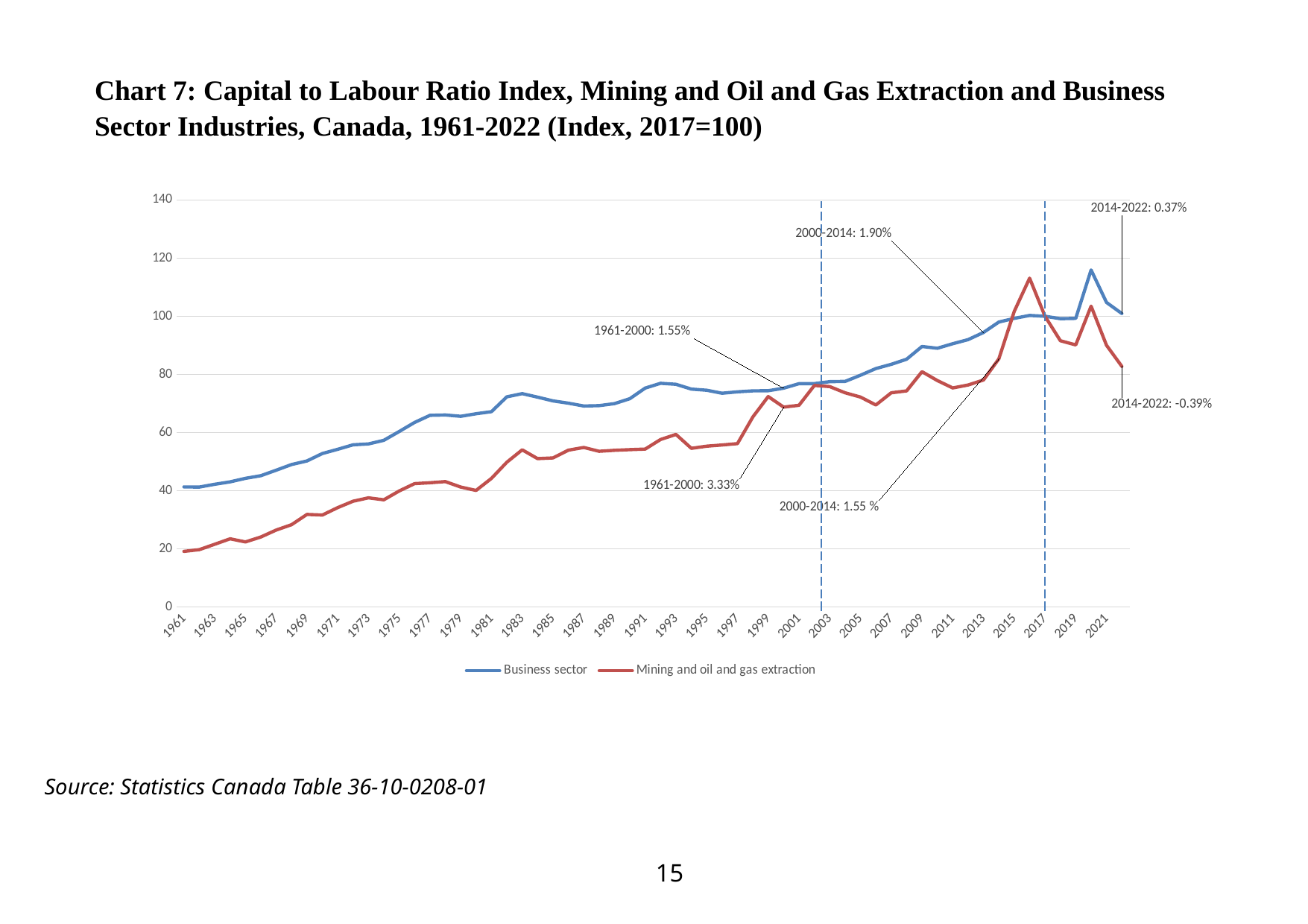
What type of chart is shown on the slide? line chart How many series does the legend list? 2 Does the Business sector series generally rise or fall from 1961 to 2000? rise What annual growth rate is annotated for the Mining and oil and gas extraction series over 1961-2000? 3.33% In 2016, which series has the higher value, Business sector or Mining and oil and gas extraction? Mining and oil and gas extraction What annual growth rate is annotated for the Business sector series over 1961-2000? 1.55% What growth rate is annotated for the Mining and oil and gas extraction series over 2014-2022? -0.39% Is the value of the Business sector series in 2020 greater or less than 100? greater What growth rate is annotated for the Business sector series over 2000-2014? 1.90% In 1961, which series has the higher value, Business sector or Mining and oil and gas extraction? Business sector What are the two series named in the legend? Business sector; Mining and oil and gas extraction Is the value of the Mining and oil and gas extraction series in 1961 greater or less than 40? less